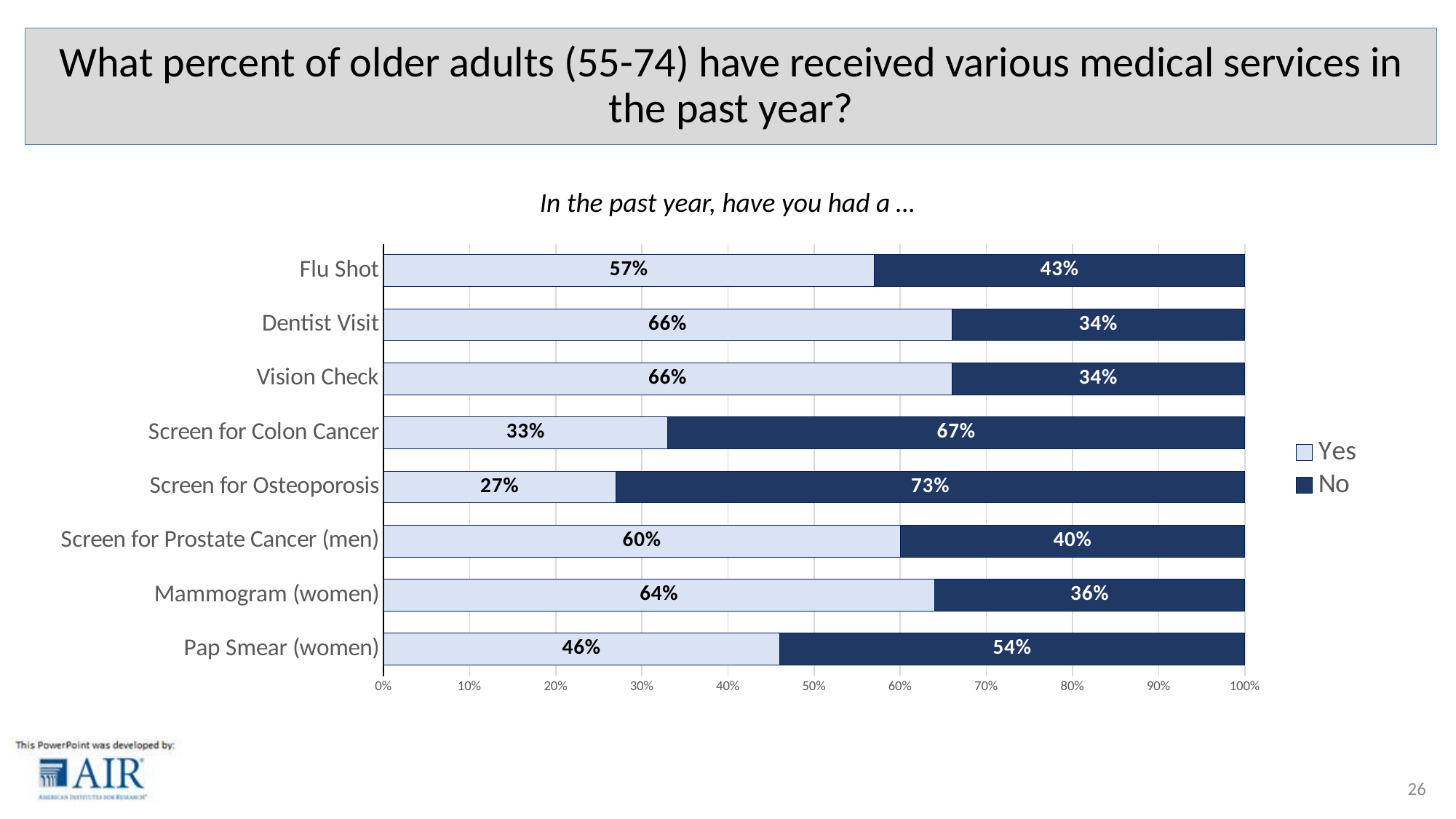
What is the No value for Screen for Osteoporosis? 73% What is the question text shown above the chart? In the past year, have you had a … What is the total of the Yes and No segments for Screen for Colon Cancer? 100% Which is larger: the Yes value for Screen for Prostate Cancer (men) or the Yes value for Flu Shot? Screen for Prostate Cancer (men) What is the Yes value for Mammogram (women)? 64% How many series does the legend list? 2 Which service has the lowest Yes percentage? Screen for Osteoporosis What is the difference between the Yes value for Dentist Visit and the Yes value for Pap Smear (women)? 20% How many medical services are listed on the chart? 8 What percentage of older adults answered Yes to having had a Flu Shot in the past year? 57% Which service has the highest No percentage? Screen for Osteoporosis What kind of chart is shown on the slide? Stacked bar chart